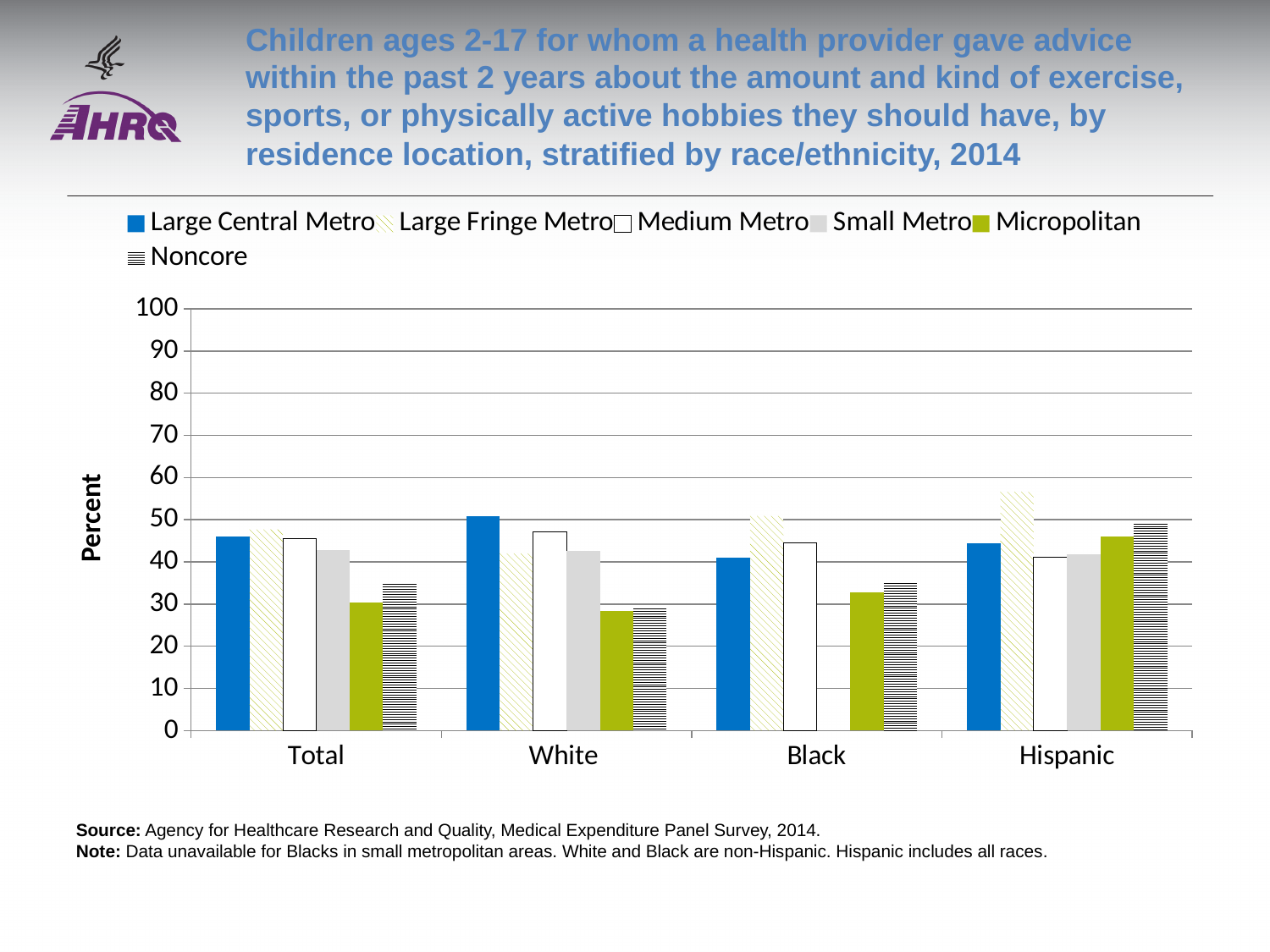
What is the label on the y axis? Percent How many race/ethnicity categories are shown on the x axis? 4 Within the Hispanic group, which residence location has the highest value? Large Fringe Metro Which is larger, the Large Central Metro value for White or for Black? White What kind of chart is shown on the slide? Bar chart Within the Black group, which residence location has the highest value? Large Fringe Metro Within the Total group, which residence location has the lowest value? Micropolitan Is the Large Fringe Metro value for Hispanic greater or less than 50? greater How many series does the legend list? 6 Is the Large Central Metro value for White greater or less than 40? greater Is the Micropolitan value for White greater or less than 40? less